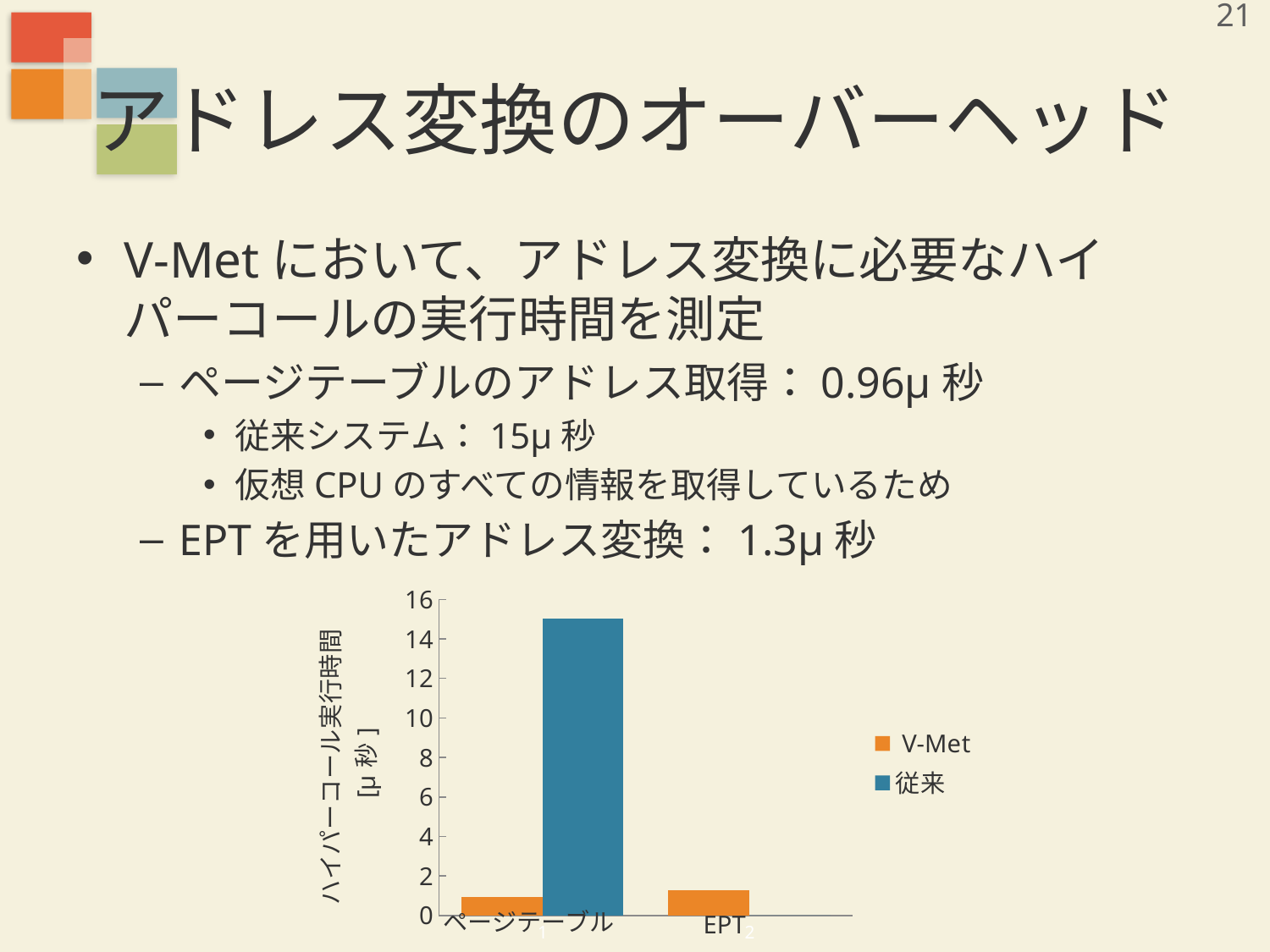
Is the V-Met value for EPT greater or less than 2? less What colour represents the V-Met series in the chart? orange What kind of chart is shown on the slide? bar chart What is the label of the chart's y axis? ハイパーコール実行時間 [μ秒] Is the 従来 value for ページテーブル greater or less than 14? greater Is the V-Met value for ページテーブル greater or less than 2? less How many categories are shown on the x axis of the chart? 2 How many series does the chart legend list? 2 For ページテーブル, which is larger: the V-Met bar or the 従来 bar? 従来 Which series has the tallest bar in the chart? 従来